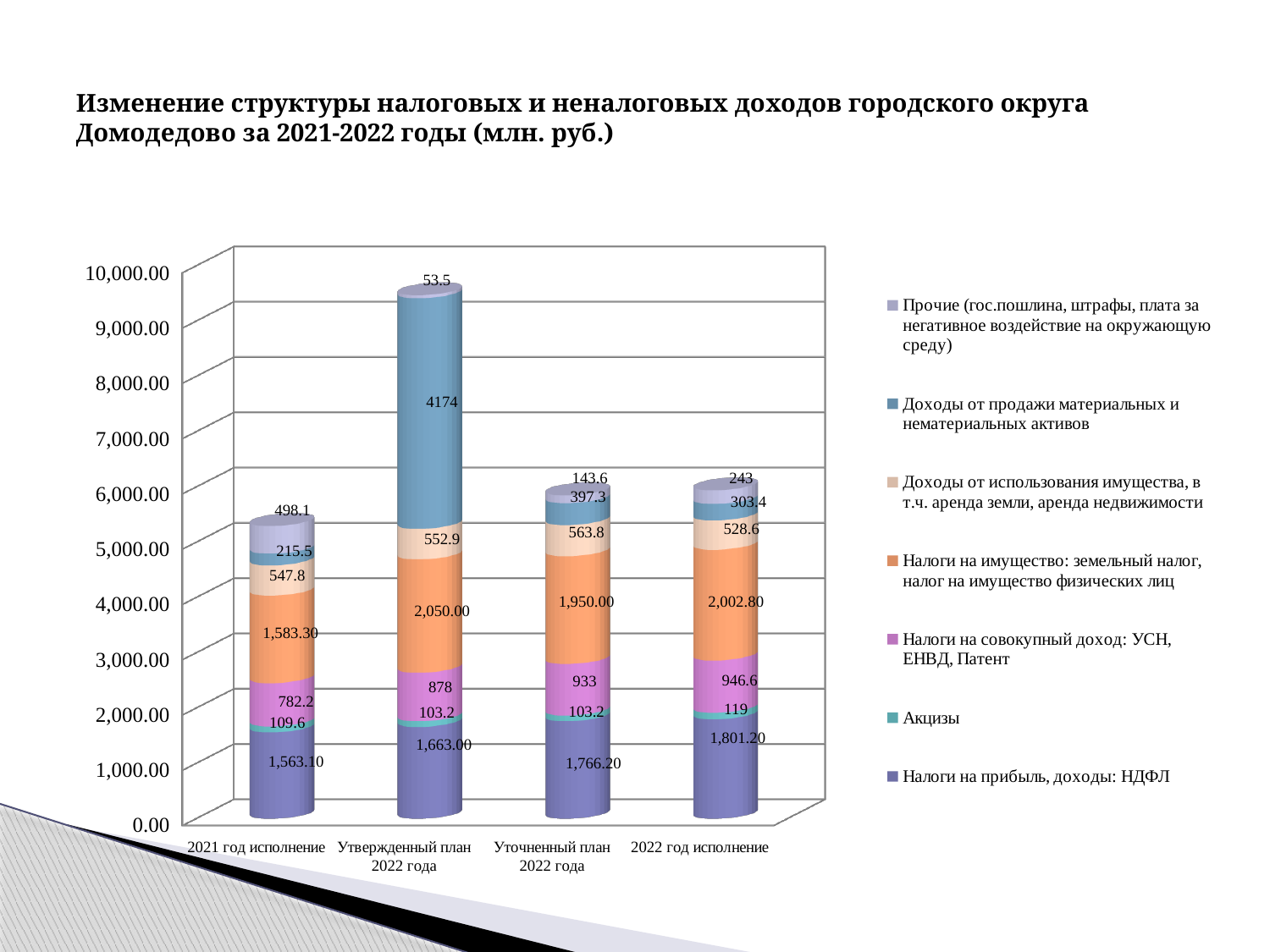
What is the value of Доходы от продажи материальных и нематериальных активов for Утвержденный план 2022 года? 4174 How many series does the legend list? 7 Which category has the lowest value for Прочие (гос.пошлина, штрафы, плата за негативное воздействие на окружающую среду)? Утвержденный план 2022 года Do the values for Налоги на прибыль, доходы: НДФЛ rise or fall from left to right across the categories? Rise How many categories are shown on the x axis? 4 What is the difference between the Акцизы values for 2022 год исполнение and 2021 год исполнение? 9.4 What is the value of Налоги на имущество for 2022 год исполнение? 2,002.80 Which category has the highest value for Налоги на прибыль, доходы: НДФЛ? 2022 год исполнение Which is larger: Налоги на совокупный доход for Уточненный план 2022 года or for Утвержденный план 2022 года? Уточненный план 2022 года What kind of chart is shown on the slide? Stacked bar chart What is the total of the stacked bar for Утвержденный план 2022 года? 9,474.6 What is the value of Налоги на прибыль, доходы: НДФЛ for 2021 год исполнение? 1,563.10